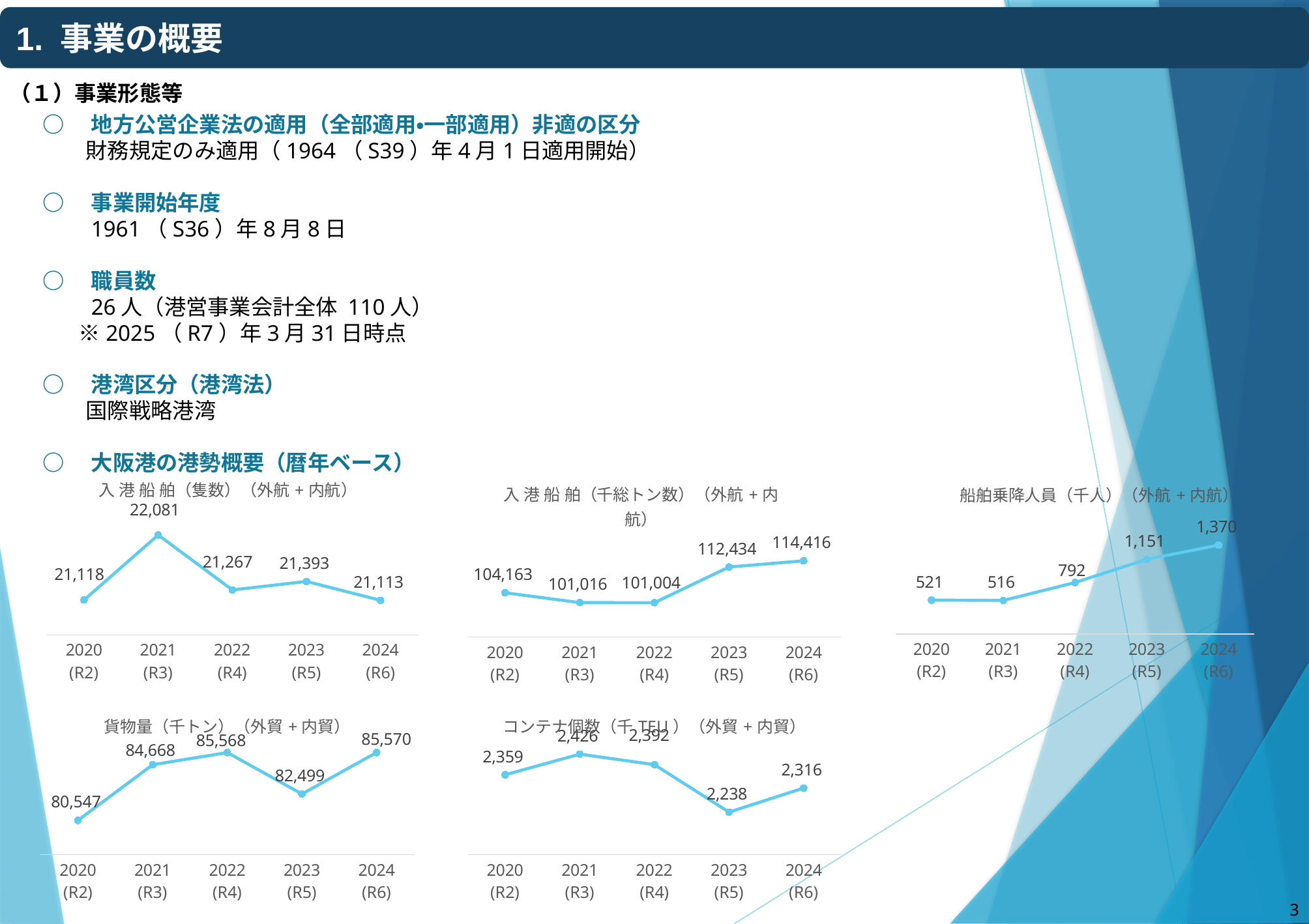
In the 船舶乗降人員（千人）（外航＋内航） chart, which year has the highest value? 2024 (R6) In the 貨物量（千トン）（外貿＋内貿） chart, which is larger, the value for 2022 (R4) or 2023 (R5)? 2022 (R4) In the 貨物量（千トン）（外貿＋内貿） chart, what is the value for 2020 (R2)? 80,547 In the 入港船舶（隻数）（外航＋内航） chart, which year has the lowest value? 2024 (R6) In the コンテナ個数（千TEU）（外貿＋内貿） chart, what is the value for 2023 (R5)? 2,238 In the 船舶乗降人員（千人）（外航＋内航） chart, what is the value for 2022 (R4)? 792 What type of chart is the 貨物量（千トン）（外貿＋内貿） chart? line chart In the 入港船舶（千総トン数）（外航＋内航） chart, what is the value for 2024 (R6)? 114,416 In the コンテナ個数（千TEU）（外貿＋内貿） chart, how many years are plotted? 5 In the 入港船舶（千総トン数）（外航＋内航） chart, what is the difference between the 2023 (R5) and 2022 (R4) values? 11,430 In the 船舶乗降人員（千人）（外航＋内航） chart, do the values generally rise or fall from 2021 (R3) to 2024 (R6)? rise In the 入港船舶（隻数）（外航＋内航） chart, what is the value for 2021 (R3)? 22,081